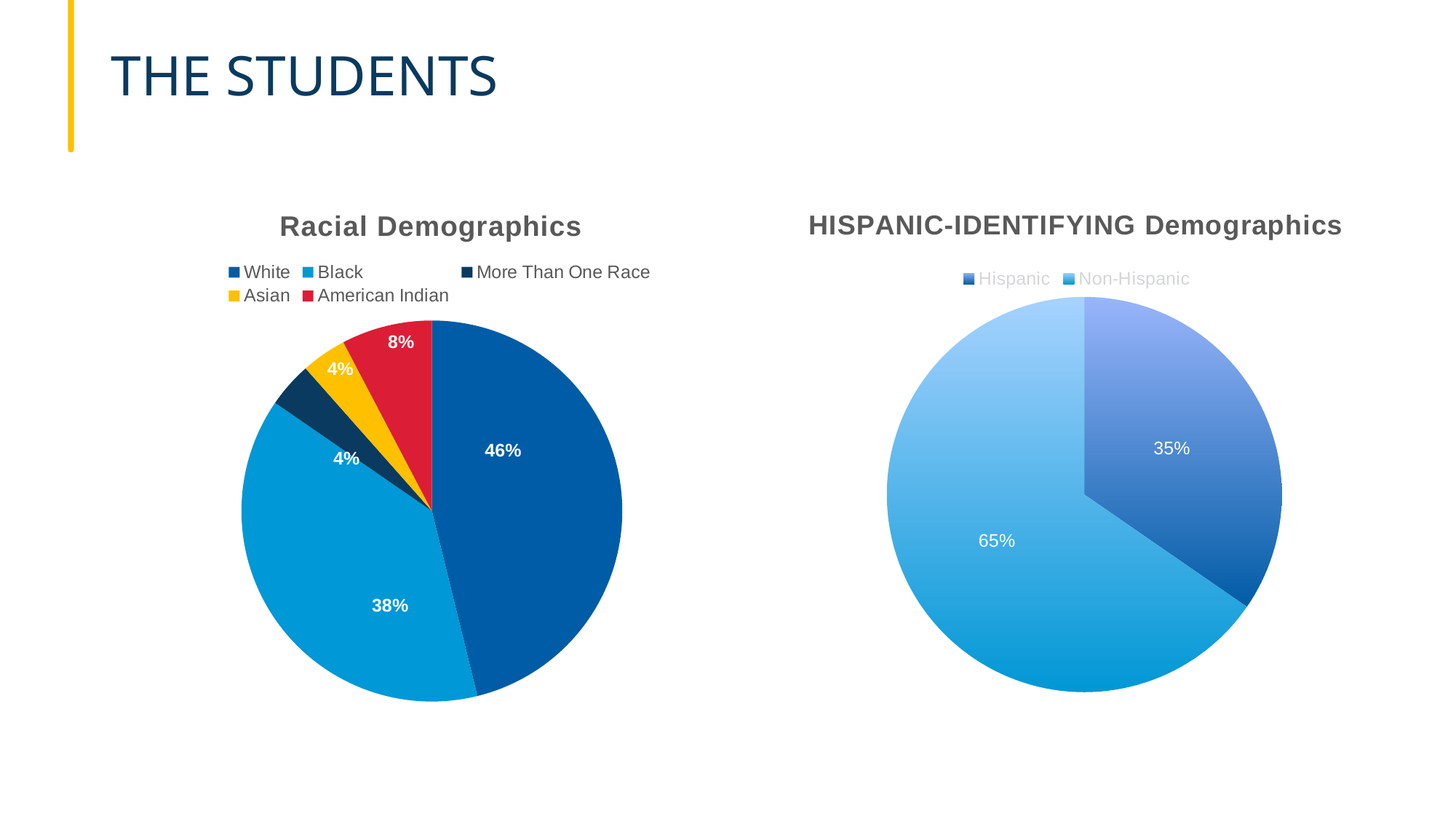
In the HISPANIC-IDENTIFYING Demographics chart, what share of students are Non-Hispanic? 65% How many categories does the Racial Demographics chart show? 5 In the Racial Demographics chart, what share of students are White? 46% What kind of chart is the Racial Demographics chart? Pie chart In the Racial Demographics chart, which category has the largest share? White In the HISPANIC-IDENTIFYING Demographics chart, what share of students are Hispanic? 35% In the Racial Demographics chart, what is the difference between the White and Black shares? 8% In the Racial Demographics chart, what share of students are American Indian? 8% How many categories does the legend of the HISPANIC-IDENTIFYING Demographics chart list? 2 In the Racial Demographics chart, what share of students are Black? 38% In the HISPANIC-IDENTIFYING Demographics chart, what is the difference between the Non-Hispanic and Hispanic shares? 30% In the Racial Demographics chart, which is larger, the American Indian share or the Asian share? American Indian